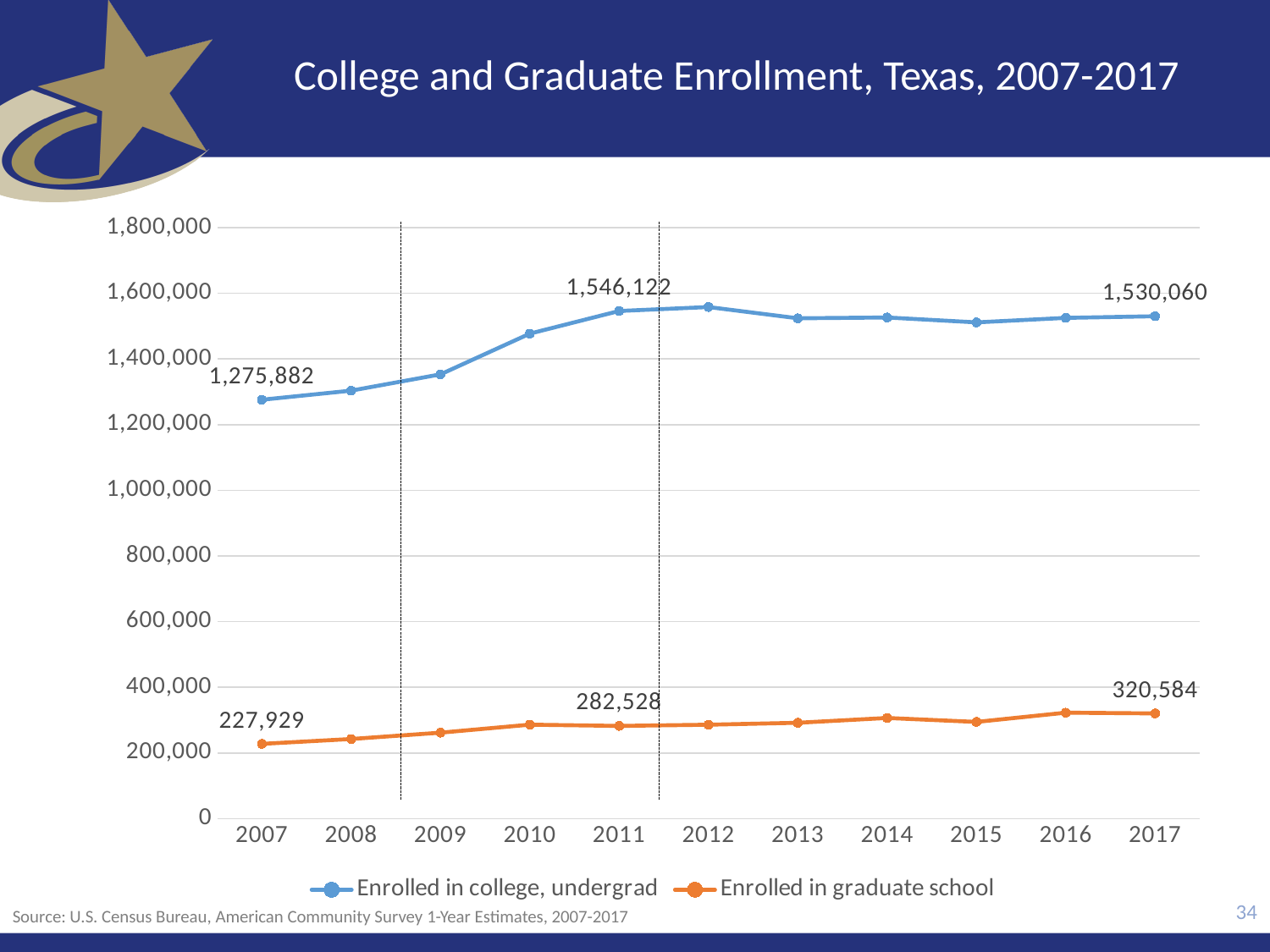
Is the value for Enrolled in college, undergrad in 2012 greater or less than 1,400,000? greater Which is larger, the undergrad enrollment in 2011 or in 2017? 2011 What is the value for Enrolled in college, undergrad in 2011? 1,546,122 What is the difference between the undergrad enrollment in 2011 and in 2007? 270,240 What is the value for Enrolled in college, undergrad in 2007? 1,275,882 What is the value for Enrolled in graduate school in 2017? 320,584 What is the difference between the graduate school enrollment in 2017 and in 2007? 92,655 What is the value for Enrolled in college, undergrad in 2017? 1,530,060 What is the value for Enrolled in graduate school in 2007? 227,929 How many years are plotted on the x axis? 11 How many series does the legend list? 2 What kind of chart is shown on the slide? line chart